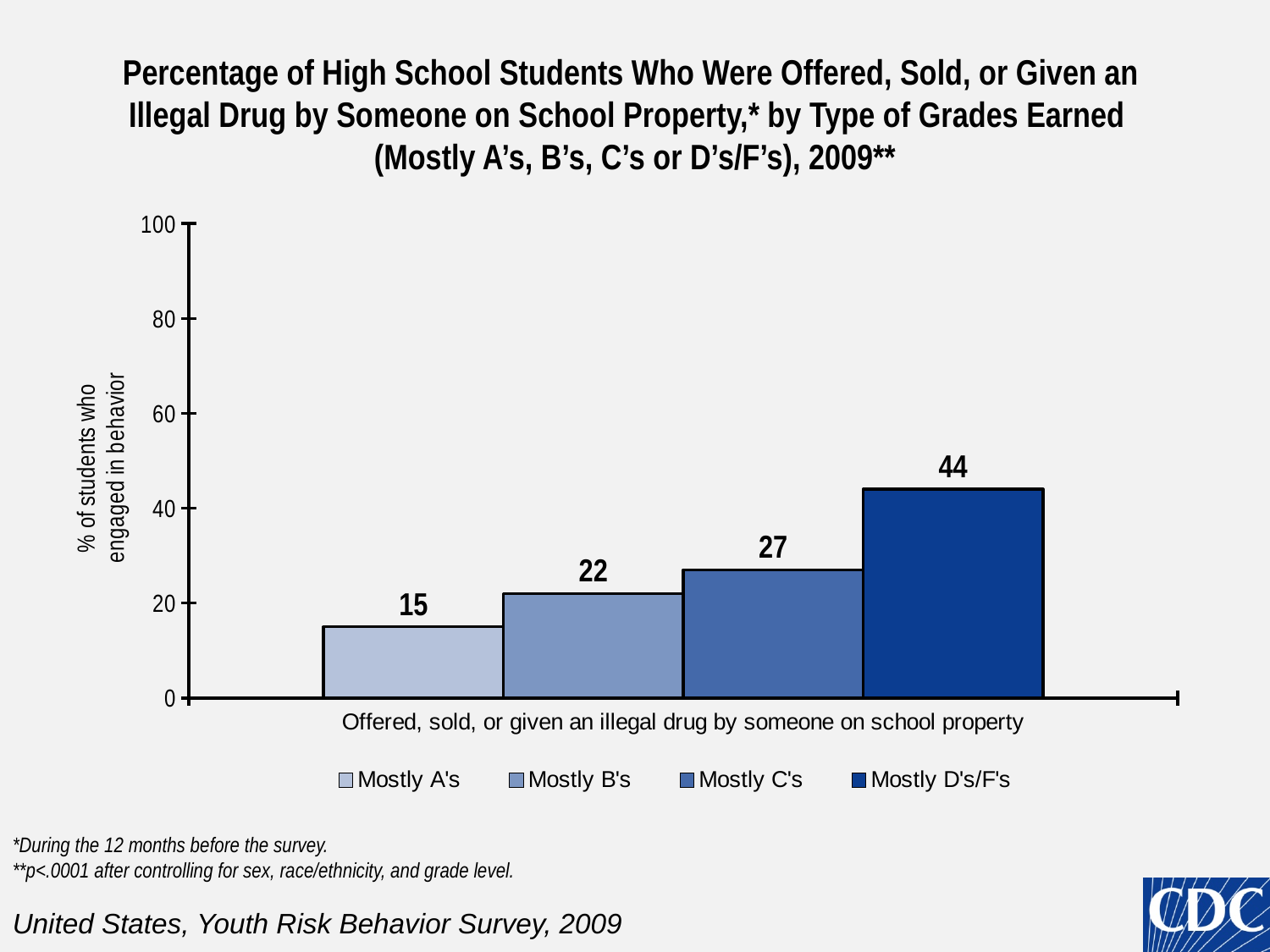
Which is larger, the value for Mostly B's or Mostly C's? Mostly C's Is the value for Mostly D's/F's greater or less than 40? greater What kind of chart is shown on the slide? Bar chart What is the value for students earning Mostly C's? 27 What is the value for students earning Mostly D's/F's? 44 What is the difference between the values for Mostly D's/F's and Mostly A's? 29 What is the label of the y axis? % of students who engaged in behavior What is the value for students earning Mostly A's? 15 What is the value for students earning Mostly B's? 22 How many series does the legend list? 4 Which grade group has the lowest percentage? Mostly A's Which grade group has the highest percentage of students who were offered, sold, or given an illegal drug on school property? Mostly D's/F's